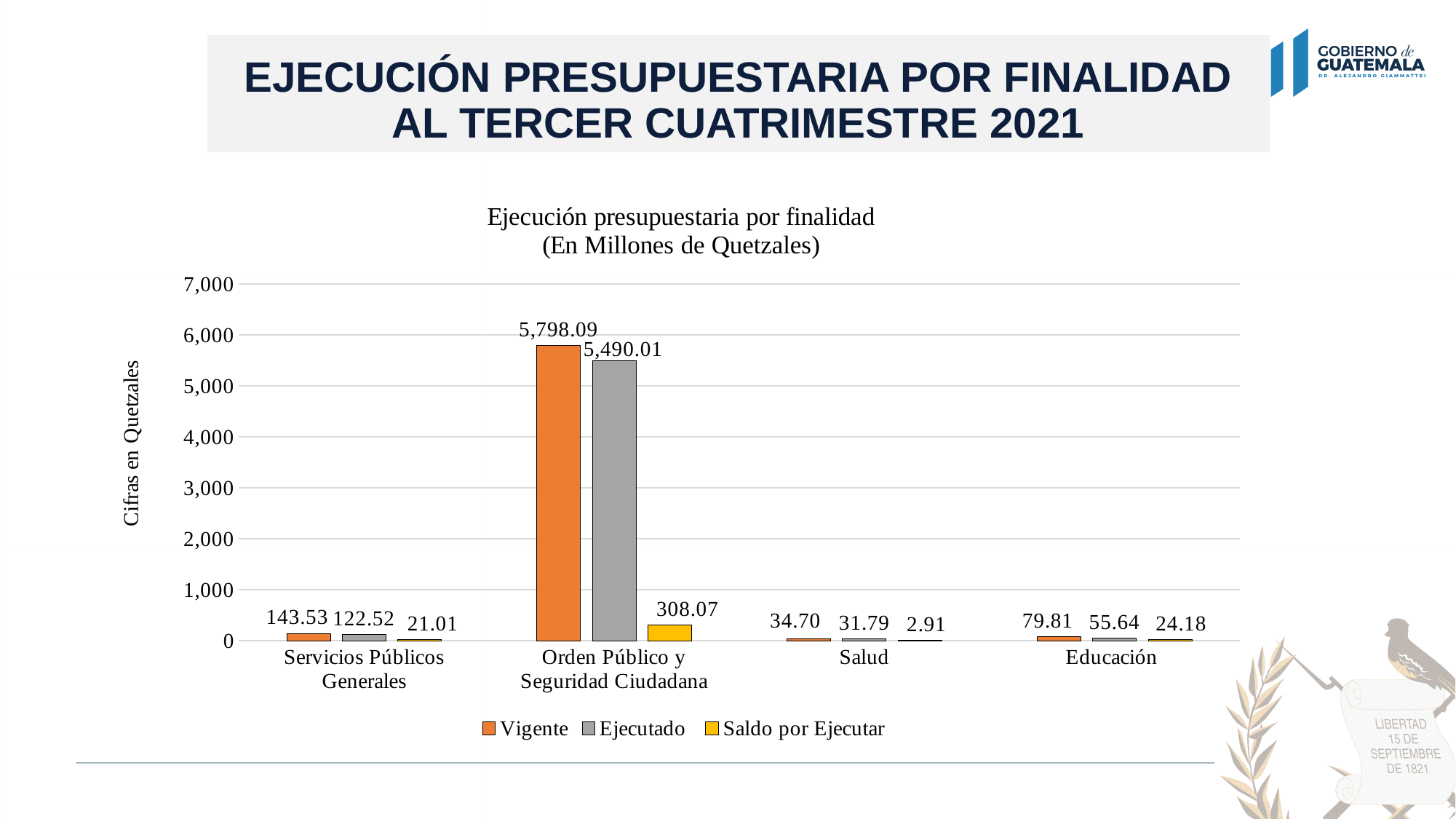
What is the Ejecutado value for Salud? 31.79 Which is larger, the Ejecutado value for Servicios Públicos Generales or the Ejecutado value for Educación? Servicios Públicos Generales What is the label of the y axis? Cifras en Quetzales What is the difference between the Vigente and Ejecutado values for Orden Público y Seguridad Ciudadana? 308.08 How many series does the legend list? 3 What is the Saldo por Ejecutar value for Educación? 24.18 What is the Vigente value for Orden Público y Seguridad Ciudadana? 5,798.09 Which category has the highest Ejecutado value? Orden Público y Seguridad Ciudadana What kind of chart is shown on the slide? Bar chart How many categories are shown on the x axis? 4 Which category has the lowest Vigente value? Salud What is the Vigente value for Servicios Públicos Generales? 143.53